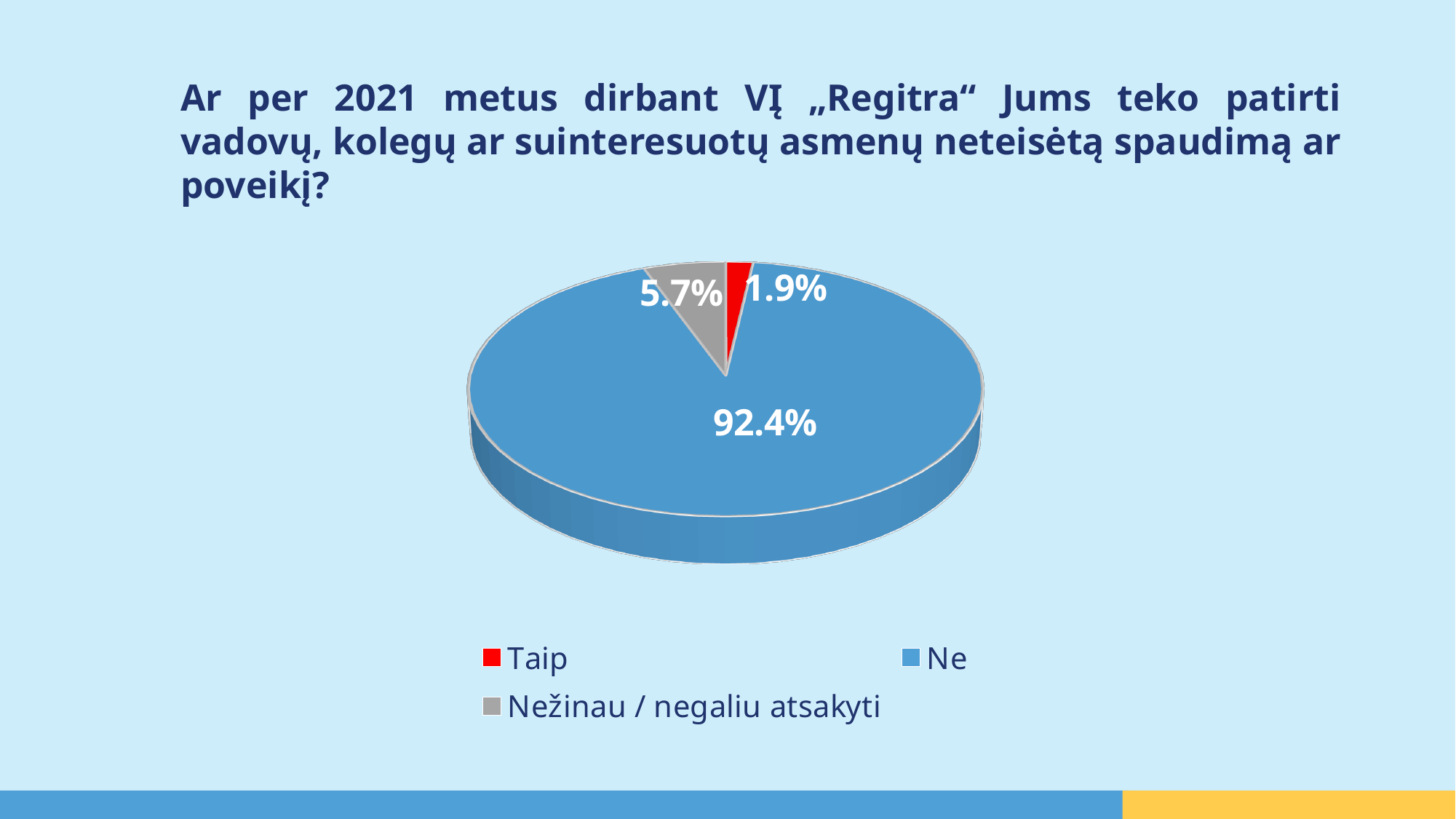
Which is larger, the share for "Taip" or the share for "Nežinau / negaliu atsakyti"? Nežinau / negaliu atsakyti How many slices does the pie chart have? 3 What share of respondents answered "Nežinau / negaliu atsakyti"? 5.7% What is the difference in percentage points between the "Nežinau / negaliu atsakyti" and "Taip" shares? 3.8 Which answer has the largest share of the pie? Ne What share of respondents answered "Ne"? 92.4% What kind of chart is shown on the slide? Pie chart Which answer has the smallest share of the pie? Taip What colour is the slice for "Taip"? Red What share of respondents answered "Taip"? 1.9% What is the difference in percentage points between the "Ne" and "Nežinau / negaliu atsakyti" shares? 86.7 How many entries does the legend list? 3